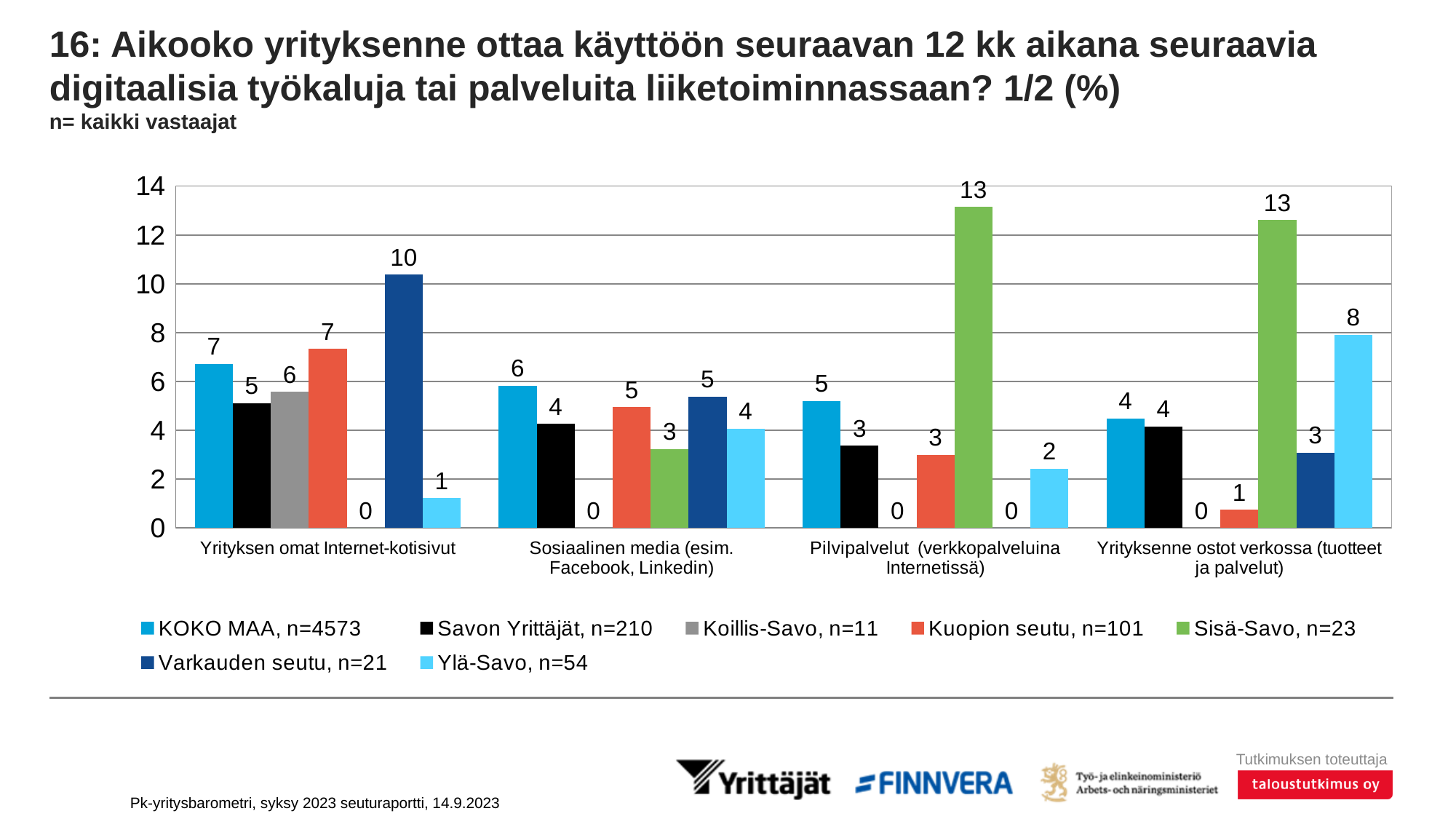
What is the sample size (n) given in the legend for Kuopion seutu? n=101 What is the value for Ylä-Savo in the category 'Yrityksenne ostot verkossa (tuotteet ja palvelut)'? 8 How many categories are shown on the x axis? 4 What is the difference between the Sisä-Savo value and the KOKO MAA value in the category 'Pilvipalvelut (verkkopalveluina Internetissä)'? 8 Which series has the lowest value in the category 'Sosiaalinen media (esim. Facebook, Linkedin)'? Koillis-Savo, n=11 How do the KOKO MAA values change across the four categories from left to right? They fall Which series has the highest value in the category 'Yrityksen omat Internet-kotisivut'? Varkauden seutu, n=21 In the category 'Yrityksenne ostot verkossa (tuotteet ja palvelut)', which is larger: the value for Ylä-Savo or the value for Varkauden seutu? Ylä-Savo What type of chart is shown on the slide? bar chart How many series does the legend list? 7 What is the value for Sisä-Savo in the category 'Pilvipalvelut (verkkopalveluina Internetissä)'? 13 What is the value for Varkauden seutu in the category 'Yrityksen omat Internet-kotisivut'? 10